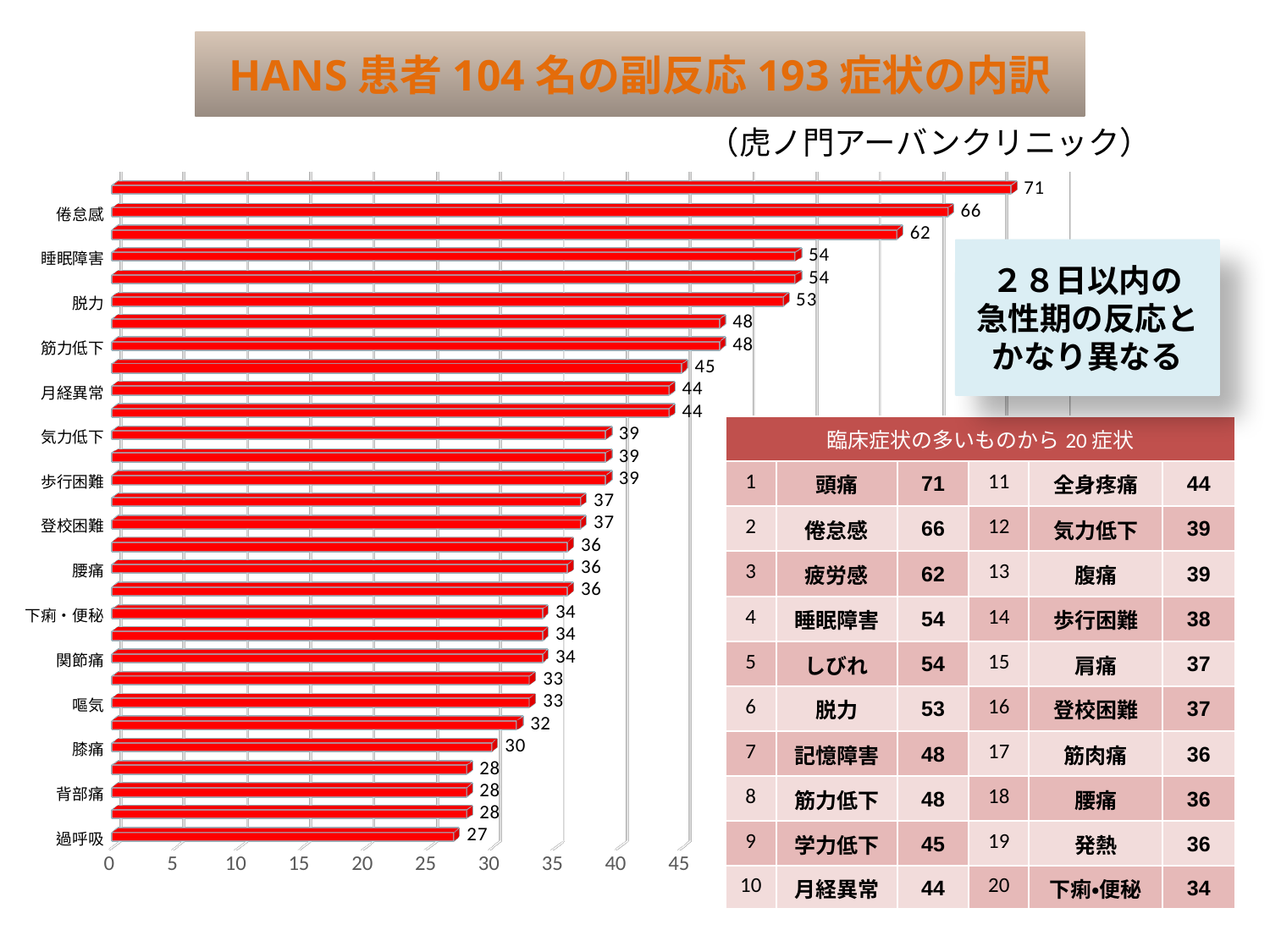
Which is larger, the value for 脱力 or the value for 筋力低下? 脱力 What is the value for 過呼吸? 27 What is the value for 倦怠感? 66 Which labelled category has the lowest value? 過呼吸 What is the difference between the values for 倦怠感 and 過呼吸? 39 What is the value for 睡眠障害? 54 How many bars are plotted on the chart? 30 What is the value for 膝痛? 30 What is the value for 脱力? 53 What kind of chart is shown on the slide? bar chart What is the title of the slide? HANS 患者 104 名の副反応 193 症状の内訳 What is the highest value shown on the chart? 71